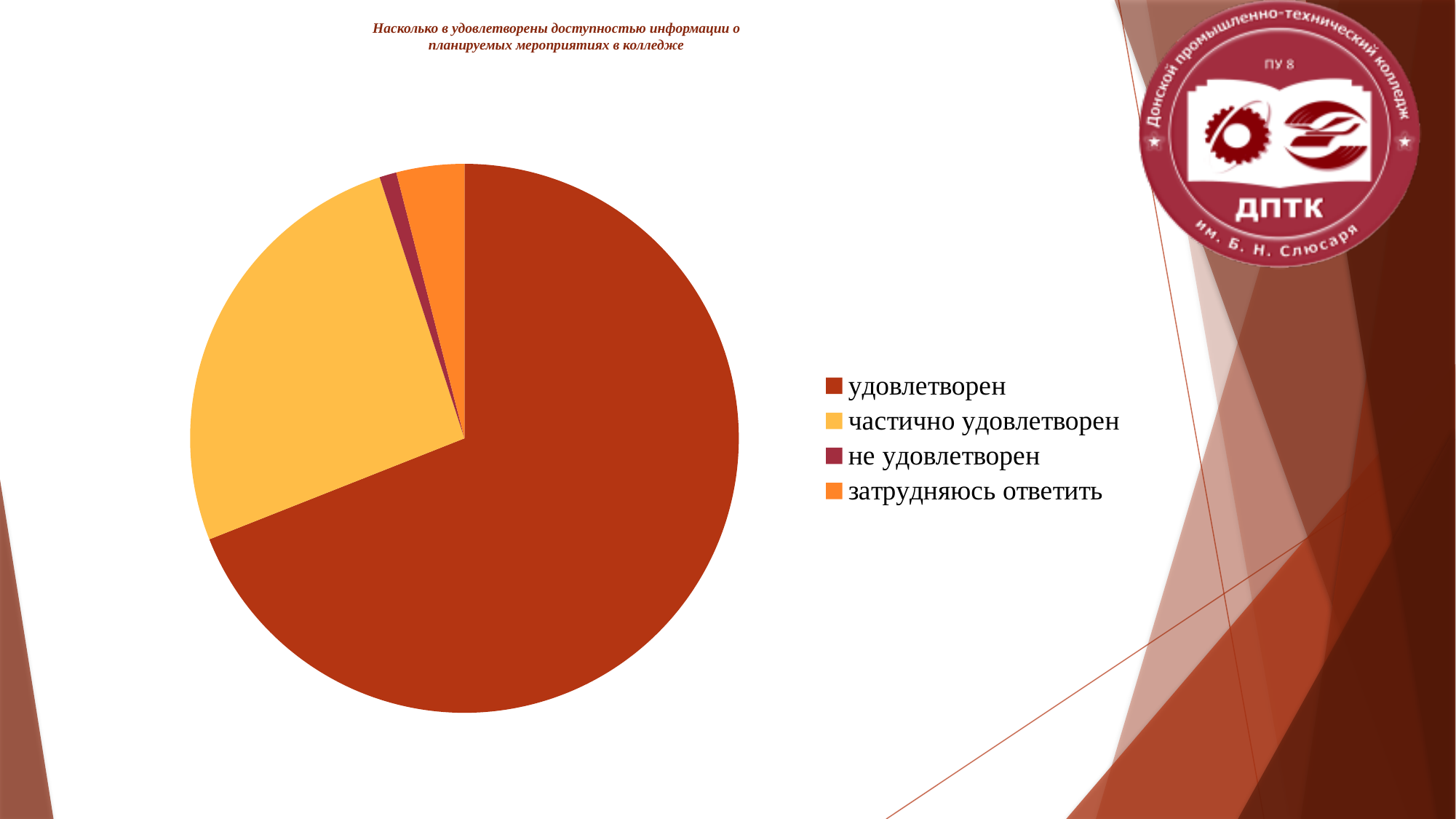
Which slice is larger: "удовлетворен" or "частично удовлетворен"? удовлетворен Which slice is larger: "затрудняюсь ответить" or "не удовлетворен"? затрудняюсь ответить Which category has the smallest slice of the pie chart? не удовлетворен What colour is the slice for "частично удовлетворен" in the pie chart? yellow What kind of chart is shown on the slide? pie chart How many entries does the legend of the pie chart list? 4 How many categories (slices) does the pie chart have? 4 Which slice is larger: "частично удовлетворен" or "затрудняюсь ответить"? частично удовлетворен Which category has the largest slice of the pie chart? удовлетворен What is the title of the chart on the slide? Насколько в удовлетворены доступностью информации о планируемых мероприятиях в колледже Which category is the second largest slice of the pie chart? частично удовлетворен